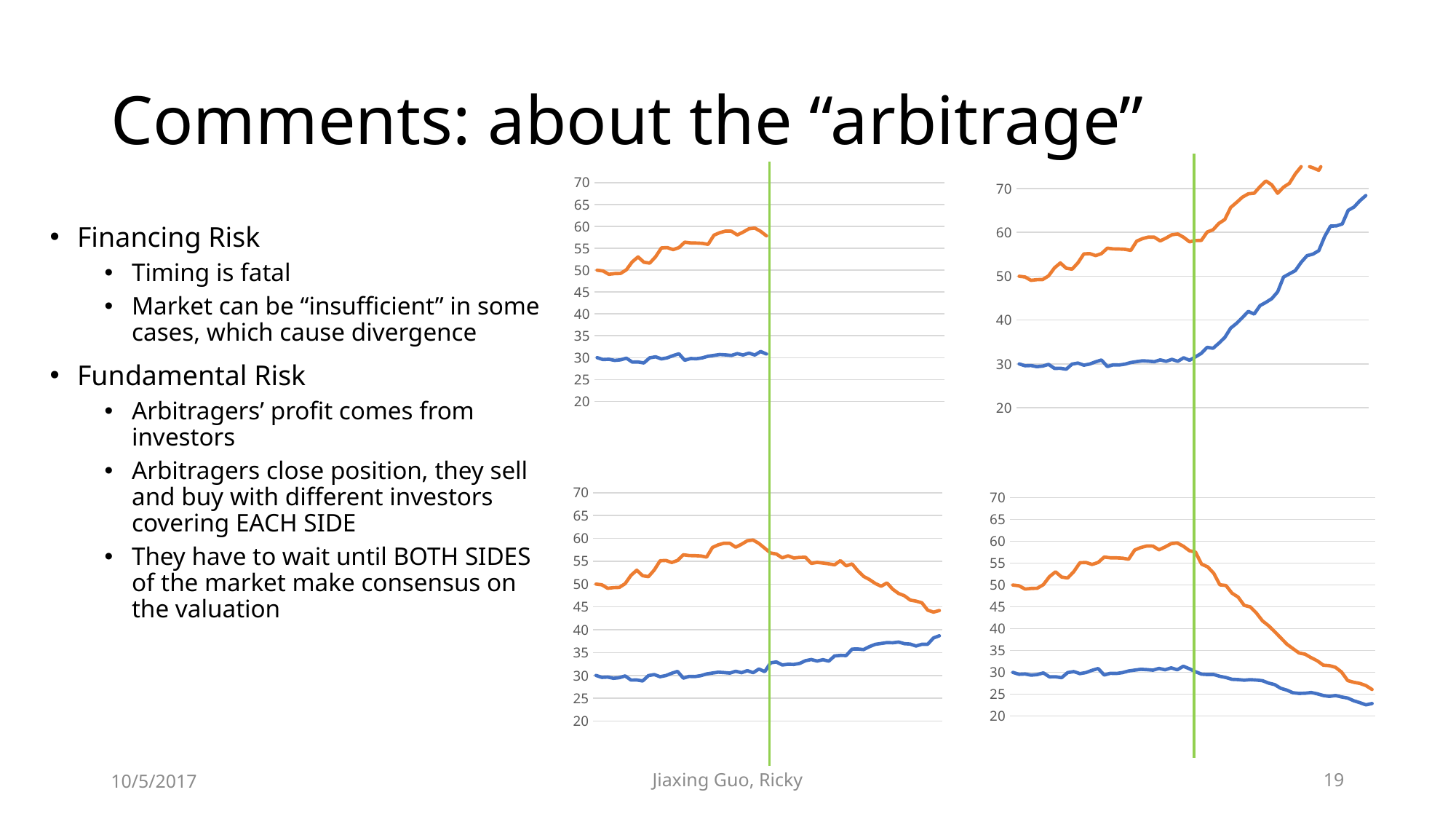
What kind of chart is the top-left chart on the slide? line chart In the bottom-right chart, does the orange line rise or fall after the green vertical line? fall How many charts are shown on the slide? 4 How many data lines (excluding the green vertical marker) are plotted in the top-right chart? 2 In the bottom-right chart, is the value of the orange line at its right end greater or less than 30? less In the top-left chart, is the value of the orange line at its right end greater or less than 55? greater In the top-left chart, is the value of the blue line at its right end greater or less than 35? less In the top-right chart, does the blue line rise or fall after the green vertical line? rise In the top-left chart, which line is higher throughout, the orange line or the blue line? orange line